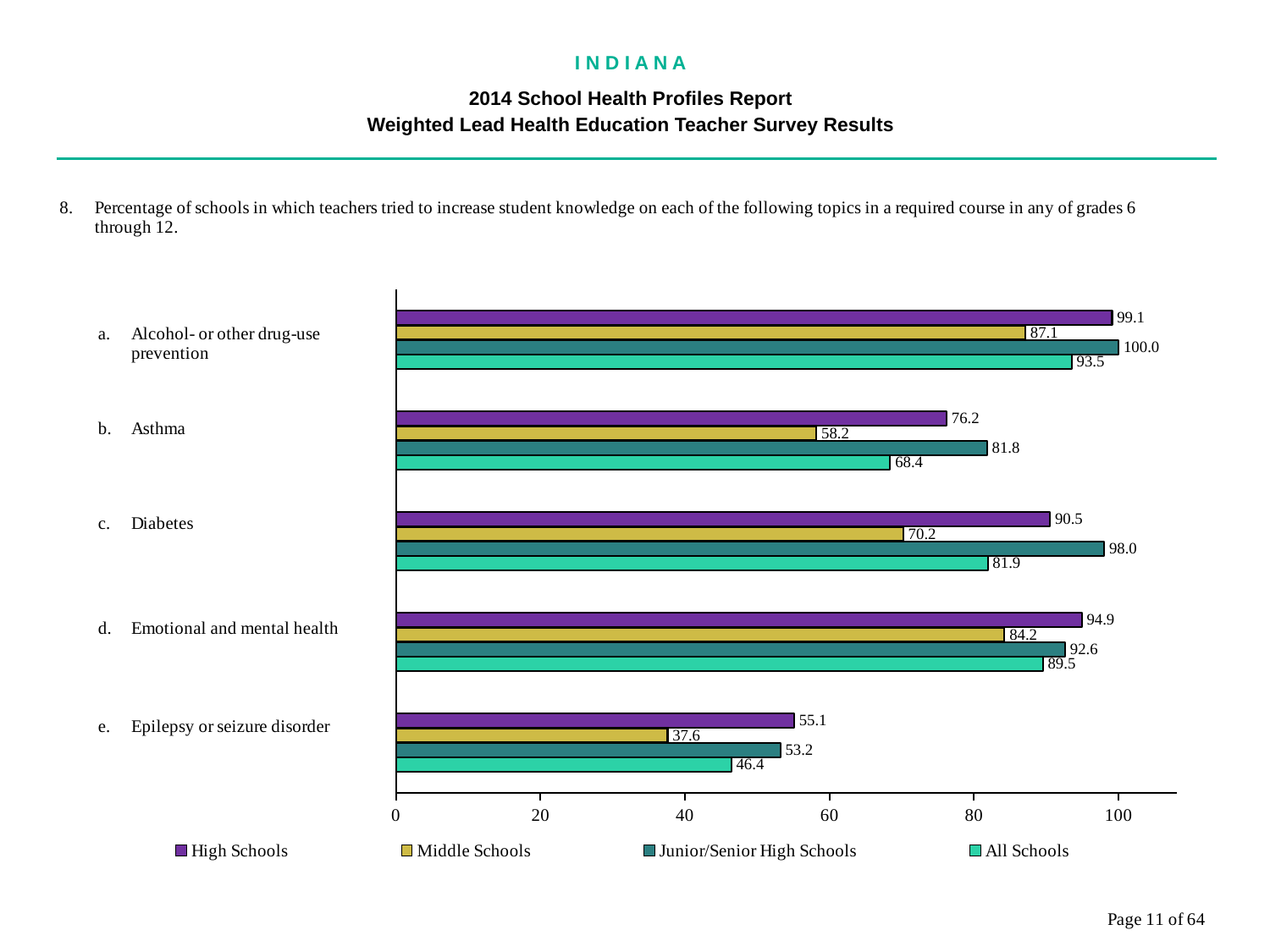
Which topic has the lowest All Schools value? Epilepsy or seizure disorder Which topic has the highest Junior/Senior High Schools value? Alcohol- or other drug-use prevention What is the value for High Schools for Alcohol- or other drug-use prevention? 99.1 Which series is shown in purple in the legend? High Schools How many topics are shown on the chart? 5 What kind of chart is shown on the slide? Bar chart How many series does the legend list? 4 Which is larger for Emotional and mental health: the High Schools value or the Junior/Senior High Schools value? High Schools What is the difference between the High Schools and Middle Schools values for Asthma? 18.0 What is the Middle Schools value for Diabetes? 70.2 What is the All Schools value for Diabetes? 81.9 What is the value for Middle Schools for Epilepsy or seizure disorder? 37.6